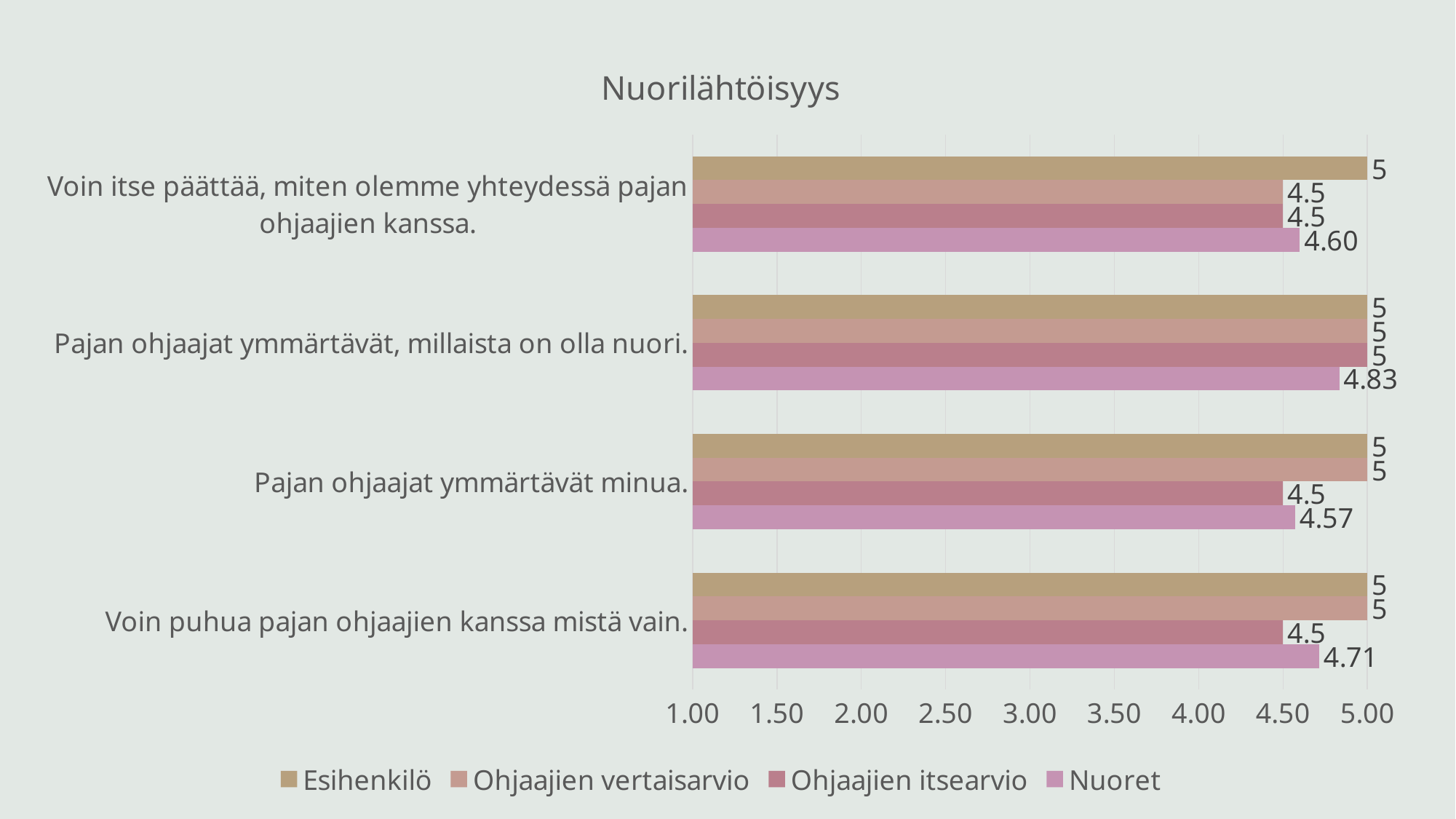
What is the Esihenkilö value for "Voin itse päättää, miten olemme yhteydessä pajan ohjaajien kanssa."? 5 What is the Ohjaajien itsearvio value for "Pajan ohjaajat ymmärtävät minua."? 4.5 How many series does the legend list? 4 What is the difference between the Esihenkilö and Nuoret values for "Voin puhua pajan ohjaajien kanssa mistä vain."? 0.29 What is the title of the chart? Nuorilähtöisyys For "Voin itse päättää, miten olemme yhteydessä pajan ohjaajien kanssa.", which is larger: the Nuoret value or the Ohjaajien itsearvio value? Nuoret What is the Nuoret value for "Pajan ohjaajat ymmärtävät, millaista on olla nuori."? 4.83 What is the Nuoret value for "Voin puhua pajan ohjaajien kanssa mistä vain."? 4.71 How many categories are shown on the chart? 4 Which category has the highest Nuoret value? Pajan ohjaajat ymmärtävät, millaista on olla nuori. What kind of chart is shown on the slide? Bar chart Which category has the lowest Nuoret value? Pajan ohjaajat ymmärtävät minua.